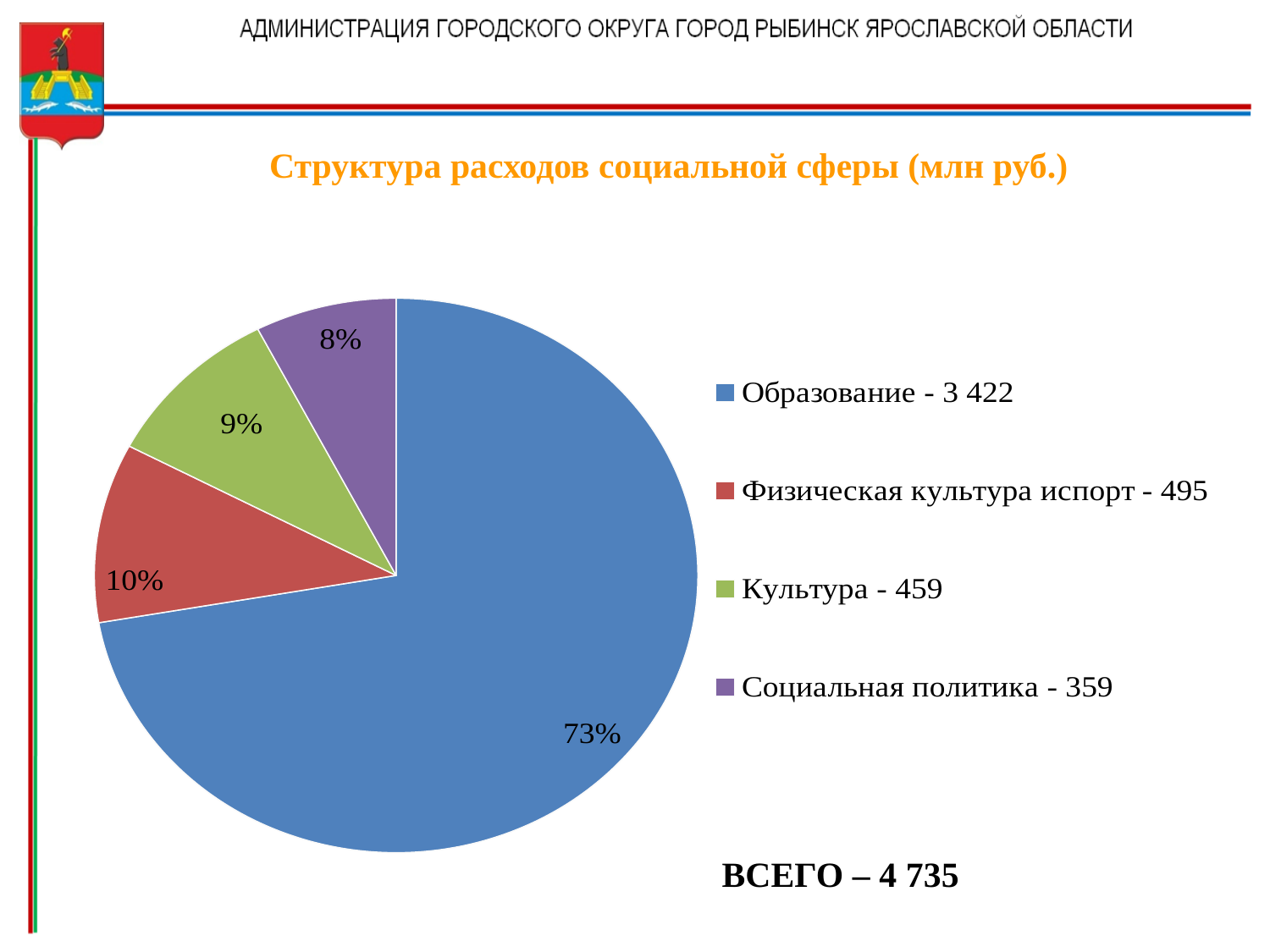
How many slices does the pie chart have? 4 What is the value shown in the legend for Физическая культура и спорт? 495 What share of the pie does Социальная политика take? 8% Which category has the smallest slice of the pie? Социальная политика Which is larger, the value for Физическая культура и спорт or the value for Культура? Физическая культура и спорт What share of the pie does Образование take? 73% What is the title of the chart? Структура расходов социальной сферы (млн руб.) What is the difference between the values for Культура and Социальная политика? 100 What is the value shown in the legend for Образование? 3 422 What share of the pie does Культура take? 9% Which category has the largest slice of the pie? Образование What kind of chart is shown on the slide? pie chart